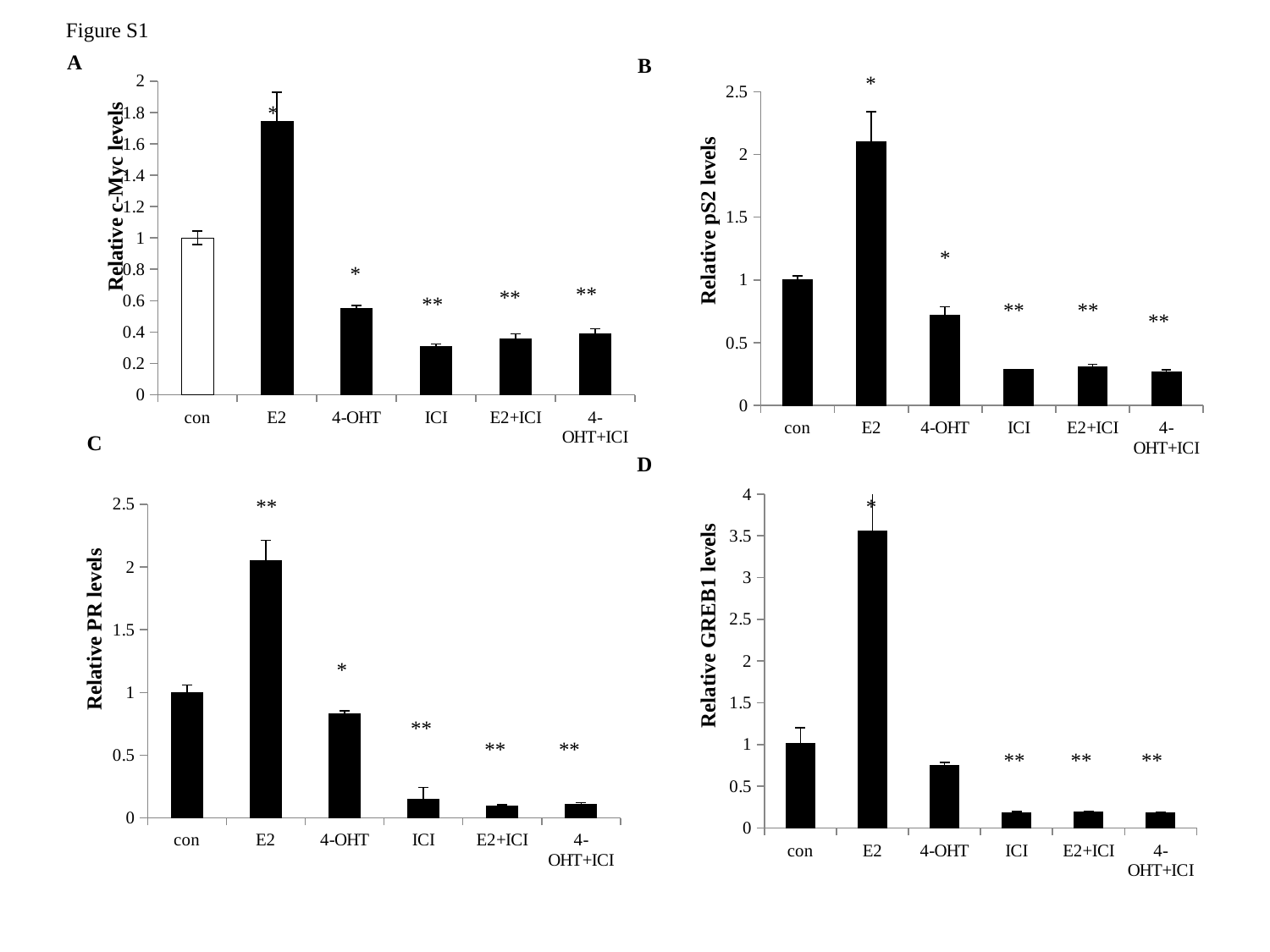
How many categories are shown on the x axis of chart C (Relative PR levels)? 6 In chart A (Relative c-Myc levels), which category has the highest value? E2 In chart D (Relative GREB1 levels), is the value for E2 greater or less than 3? greater In chart C (Relative PR levels), which category has the highest value? E2 In chart A (Relative c-Myc levels), is the value for E2 greater or less than 1.6? greater In chart B (Relative pS2 levels), is the value for 4-OHT greater or less than 1? less In chart B (Relative pS2 levels), which is larger, the value for con or the value for ICI? con What kind of chart is chart D (Relative GREB1 levels)? bar chart In chart B (Relative pS2 levels), which category has the highest value? E2 In chart D (Relative GREB1 levels), which is larger, the value for 4-OHT or the value for E2+ICI? 4-OHT